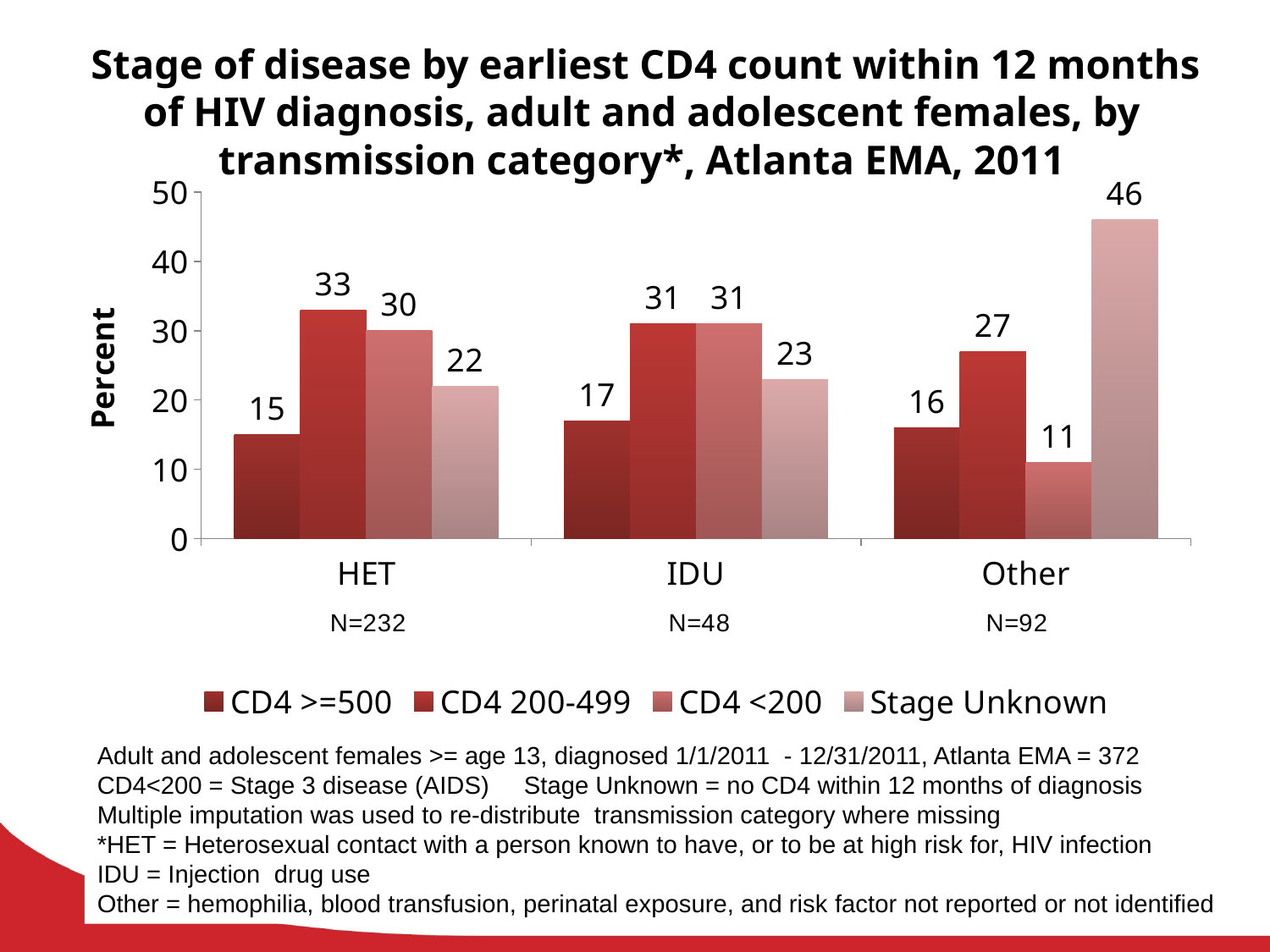
How many series does the legend list? 4 What is the value for Stage Unknown in the Other category? 46 What is the label of the y axis? Percent Which series has the lowest value in the HET category? CD4 >=500 What is the value for CD4 200-499 in the HET category? 33 Which series has the highest value in the Other category? Stage Unknown How many transmission categories are shown on the x axis? 3 What is the N shown under the IDU category? N=48 What is the difference between the Stage Unknown value and the CD4 <200 value in the Other category? 35 What is the value for CD4 >=500 in the IDU category? 17 What kind of chart is shown on the slide? Bar chart Which is larger: the CD4 <200 value for HET or the CD4 <200 value for IDU? IDU